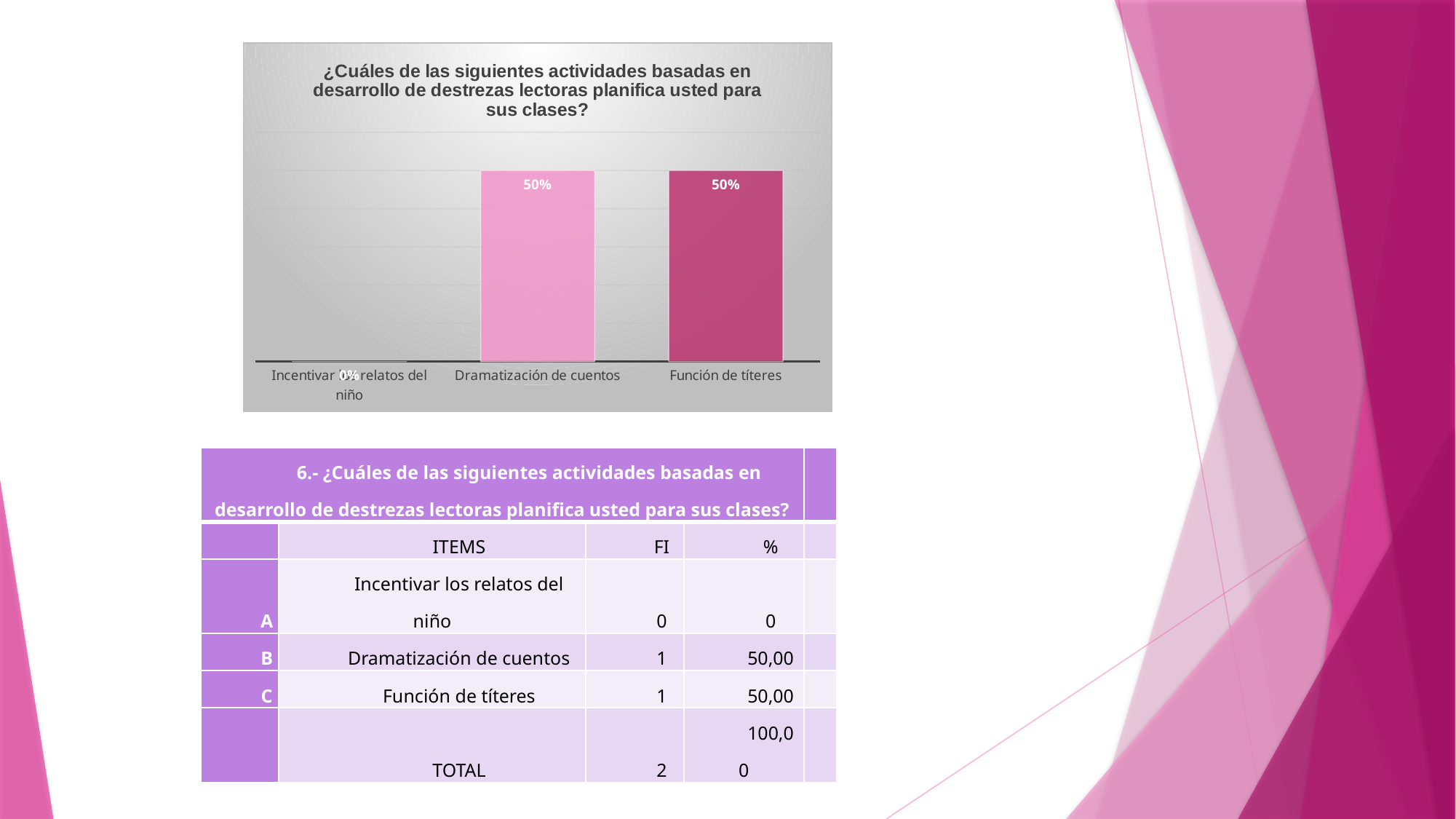
What is the difference between the values for Dramatización de cuentos and Incentivar los relatos del niño? 50% What is the value shown for Función de títeres? 50% What is the title of the chart? ¿Cuáles de las siguientes actividades basadas en desarrollo de destrezas lectoras planifica usted para sus clases? Which is larger, the value for Función de títeres or the value for Incentivar los relatos del niño? Función de títeres Which category has the lowest value? Incentivar los relatos del niño What is the value shown for Incentivar los relatos del niño? 0% Which category is plotted with the darker pink bar? Función de títeres What is the value shown for Dramatización de cuentos? 50% What is the total of the values for Dramatización de cuentos and Función de títeres? 100% How many categories are shown on the x axis of the chart? 3 What kind of chart is shown on the slide? Bar chart